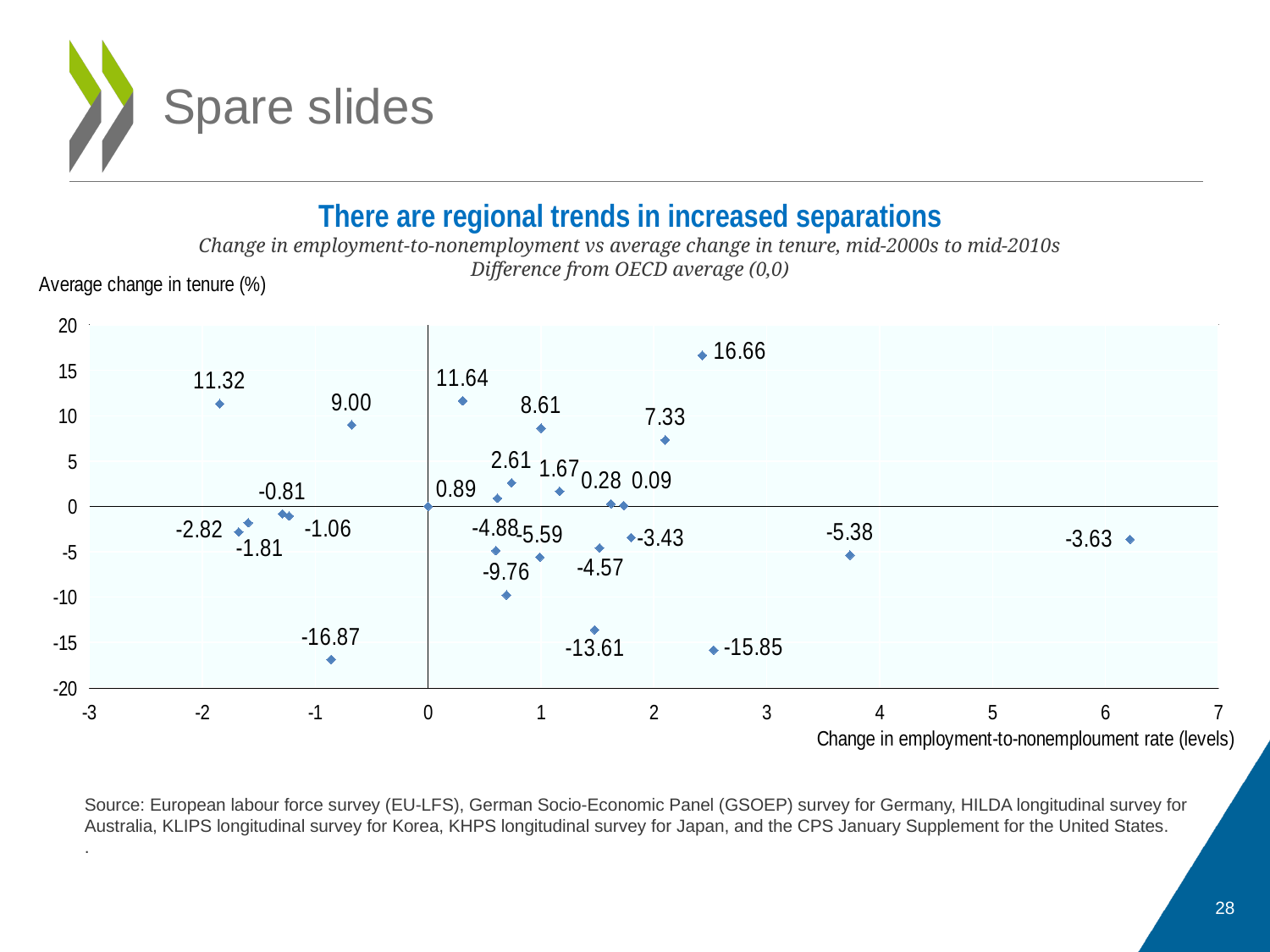
What is the difference between the highest labelled value (16.66) and the lowest labelled value (-16.87)? 33.53 Which is larger, the point labelled 11.32 or the point labelled 11.64? 11.64 What kind of chart is shown on the slide? scatter chart What is the title of the chart? There are regional trends in increased separations What is the lowest data label value shown on the chart? -16.87 Is the change in employment-to-nonemployment rate for the point labelled -5.38 greater or less than 3? greater Is the change in employment-to-nonemployment rate for the point labelled 16.66 greater or less than 2? greater How many points have a positive labelled average change in tenure? 11 Is the change in employment-to-nonemployment rate for the point labelled -3.63 greater or less than 6? greater What is the highest data label value shown on the chart? 16.66 How many points have a labelled average change in tenure below -10? 3 What is the label of the vertical axis? Average change in tenure (%)